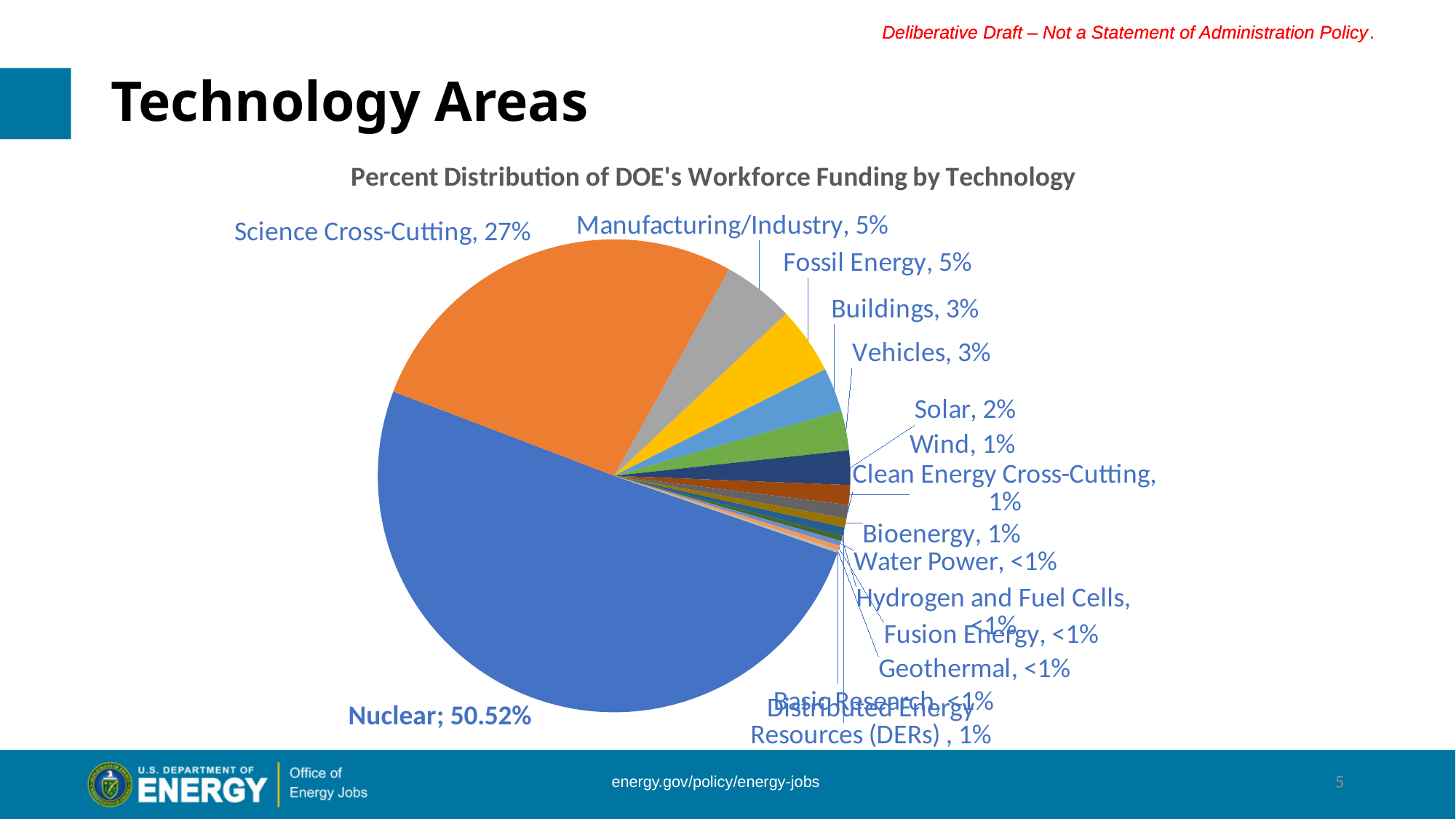
Which is larger, the share for Science Cross-Cutting or the share for Manufacturing/Industry? Science Cross-Cutting What share of DOE's workforce funding goes to Nuclear? 50.52% What percentage is shown for Solar? 2% What is the difference in percentage points between Science Cross-Cutting (27%) and Fossil Energy (5%)? 22 percentage points What type of chart is shown on the slide? Pie chart What value is shown for Water Power? <1% What percentage is shown for Buildings? 3% What percentage is shown for Science Cross-Cutting? 27% What is the difference in percentage points between Nuclear (50.52%) and Science Cross-Cutting (27%)? 23.52 percentage points What is the title of the chart? Percent Distribution of DOE's Workforce Funding by Technology Which technology area has the largest share of the pie? Nuclear What percentage is shown for Manufacturing/Industry? 5%